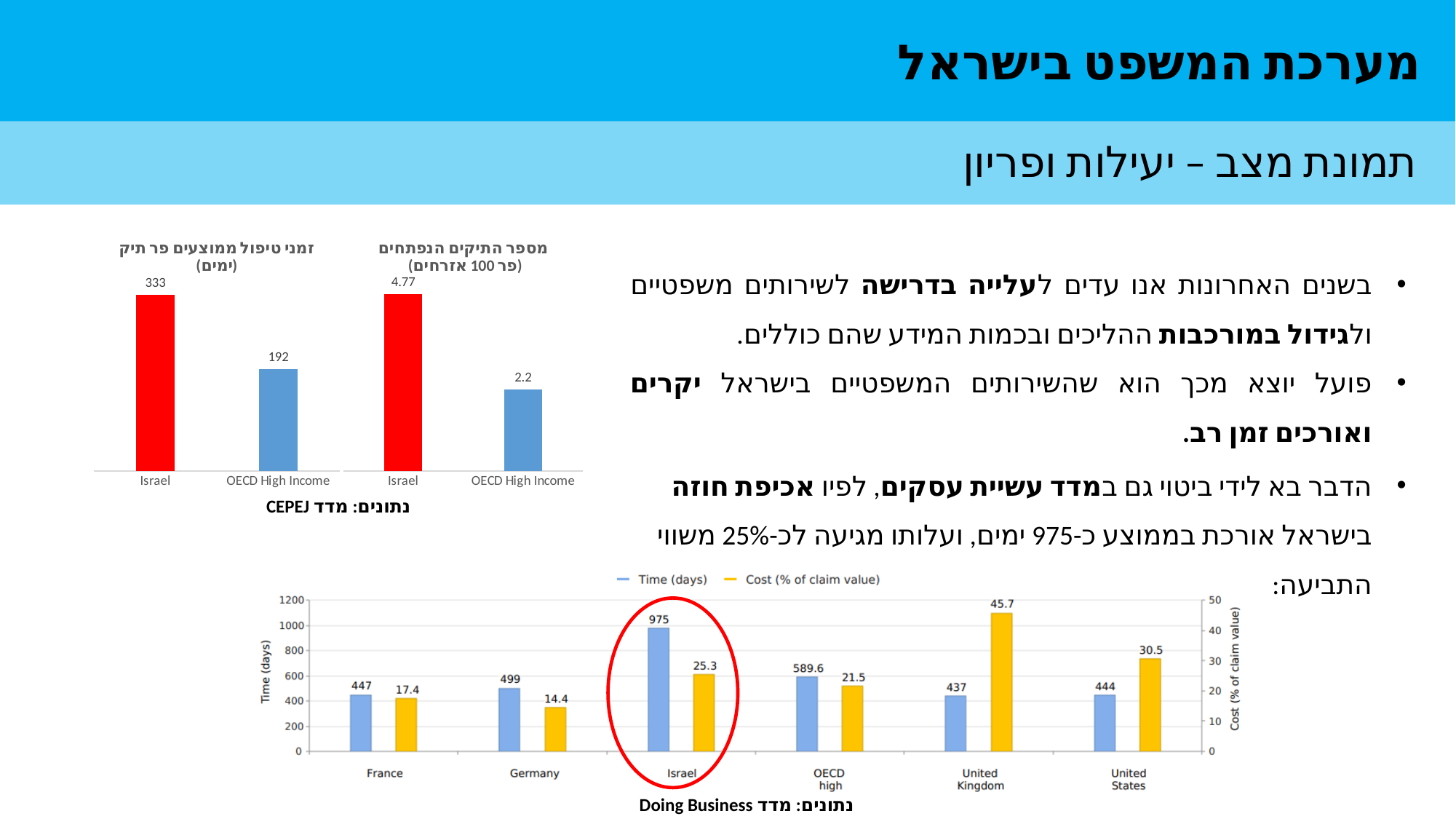
In the bottom chart (Doing Business), what is the difference in Time (days) between Israel and France? 528 In the bottom chart (Doing Business), which country has the highest Time (days) value? Israel In the bottom chart (Doing Business), what is the Time (days) value for Israel? 975 In the top-left chart titled 'זמני טיפול ממוצעים פר תיק (ימים)', what is the value for Israel? 333 In the bottom chart (Doing Business), which has a higher Cost (% of claim value): the United States or OECD high? United States What kind of chart is the bottom chart (Doing Business)? Bar chart In the bottom chart (Doing Business), what is the Cost (% of claim value) for the United Kingdom? 45.7 In the chart titled 'מספר התיקים הנפתחים (פר 100 אזרחים)', what is the value for OECD High Income? 2.2 In the top-left chart titled 'זמני טיפול ממוצעים פר תיק (ימים)', what is the difference between Israel and OECD High Income? 141 In the bottom chart (Doing Business), how many countries or groups are shown on the x axis? 6 In the bottom chart (Doing Business), which country has the lowest Cost (% of claim value)? Germany In the bottom chart (Doing Business), how many series does the legend list? 2